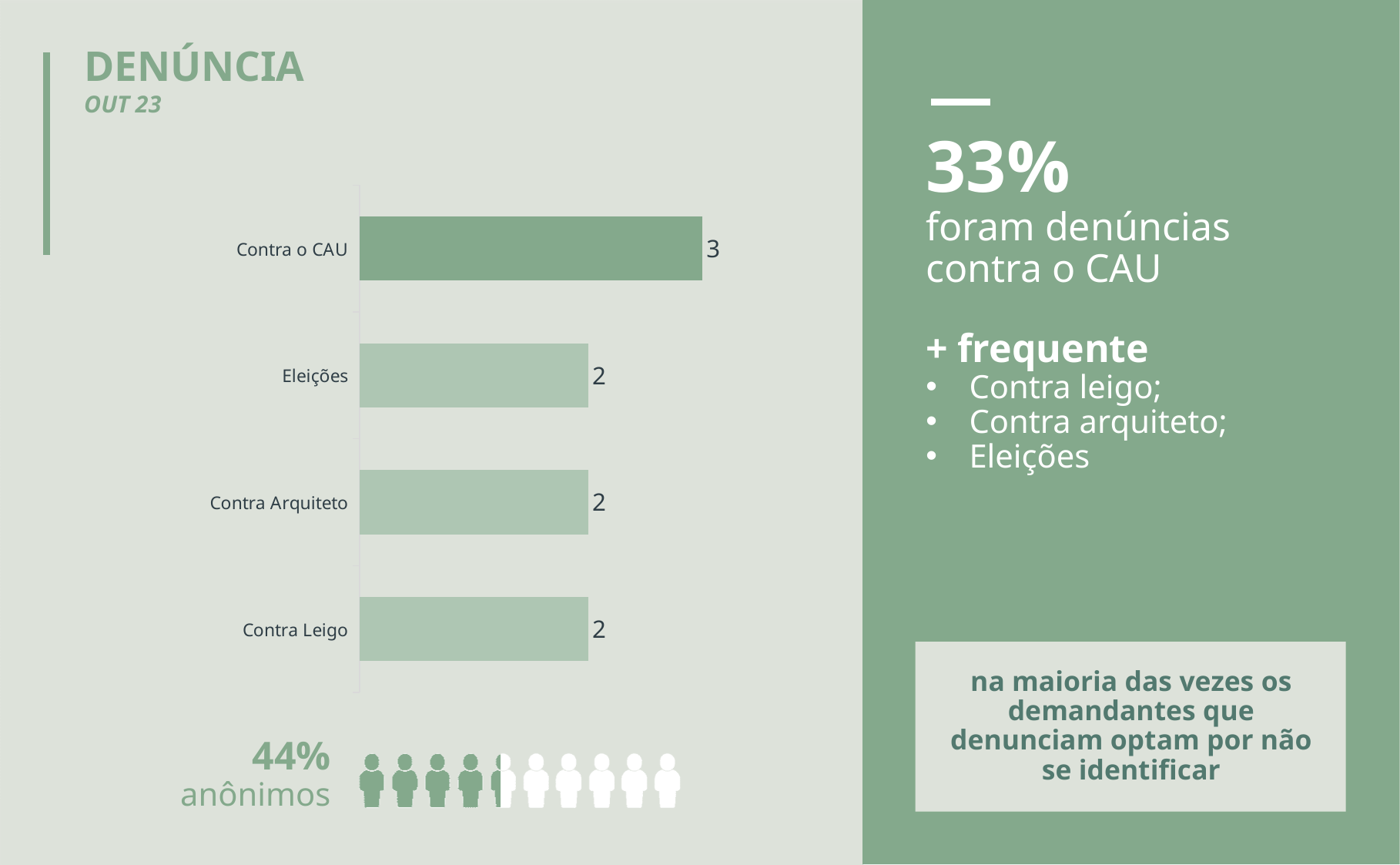
What is the value for Contra Arquiteto? 2 How many categories are shown in the chart? 4 Which category has the highest value? Contra o CAU Which is larger, the value for Contra o CAU or the value for Contra Leigo? Contra o CAU What is the value for Contra o CAU? 3 What is the value for Eleições? 2 What kind of chart is shown on the slide? Bar chart What is the value for Contra Leigo? 2 What is the difference between the values for Contra o CAU and Eleições? 1 Which bar is shown in a darker shade of green than the others? Contra o CAU What is the title shown above the chart? DENÚNCIA What is the total of all the values shown in the chart? 9